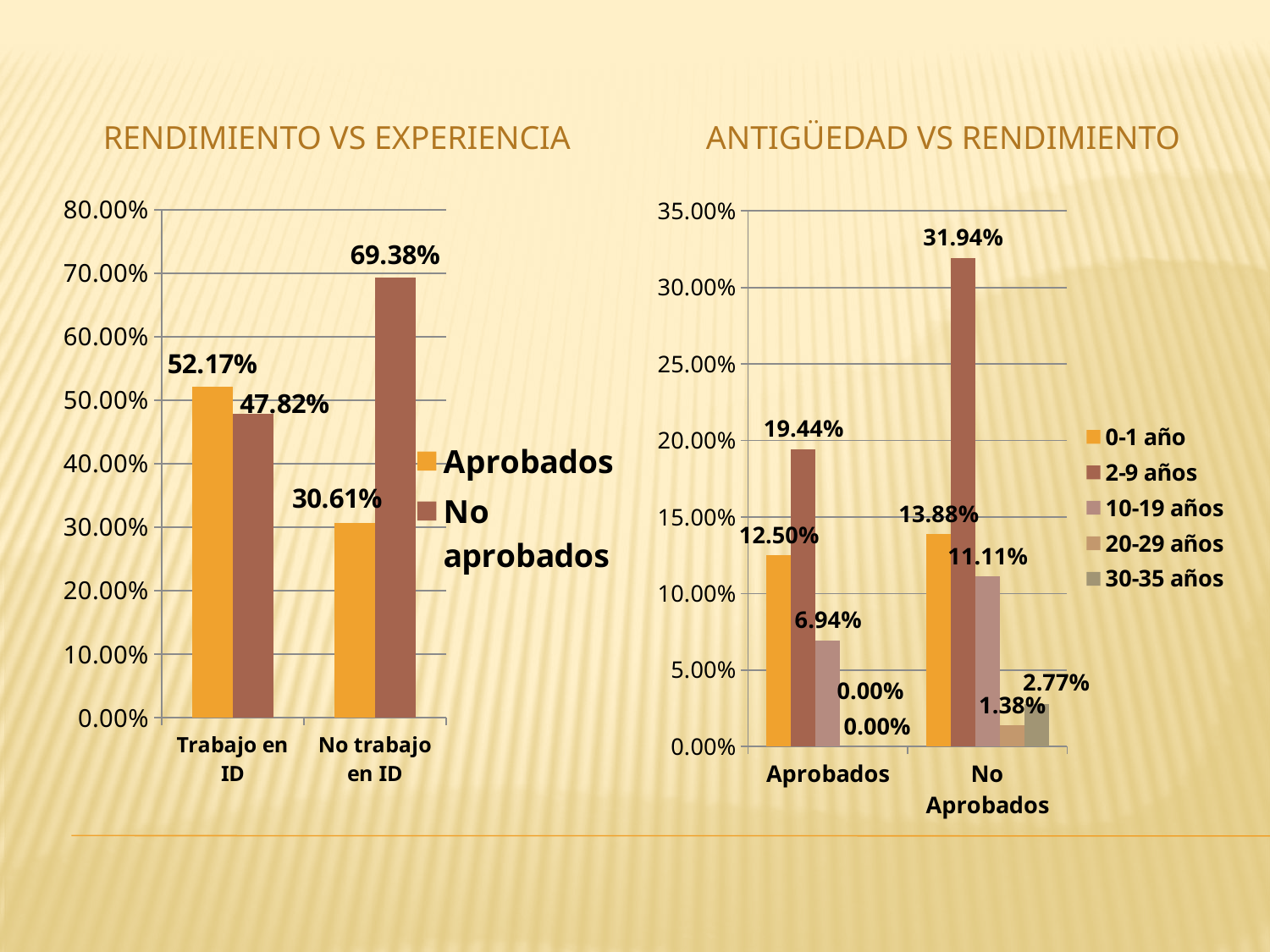
In the ANTIGÜEDAD VS RENDIMIENTO chart, what is the difference between the 0-1 año values for No Aprobados and Aprobados? 1.38% In the ANTIGÜEDAD VS RENDIMIENTO chart, which series has the highest value in the No Aprobados category? 2-9 años In the ANTIGÜEDAD VS RENDIMIENTO chart, what is the value for 2-9 años in the No Aprobados category? 31.94% In the ANTIGÜEDAD VS RENDIMIENTO chart, how many series does the legend list? 5 In the RENDIMIENTO VS EXPERIENCIA chart, which is larger in the Trabajo en ID category, Aprobados or No aprobados? Aprobados What kind of chart is the RENDIMIENTO VS EXPERIENCIA chart? Bar chart In the RENDIMIENTO VS EXPERIENCIA chart, what is the value for No aprobados in the No trabajo en ID category? 69.38% In the RENDIMIENTO VS EXPERIENCIA chart, what is the value for Aprobados in the Trabajo en ID category? 52.17% In the ANTIGÜEDAD VS RENDIMIENTO chart, how many categories are shown on the x axis? 2 In the RENDIMIENTO VS EXPERIENCIA chart, how many series does the legend list? 2 In the ANTIGÜEDAD VS RENDIMIENTO chart, what is the value for 10-19 años in the Aprobados category? 6.94% In the RENDIMIENTO VS EXPERIENCIA chart, what is the difference between Aprobados and No aprobados in the No trabajo en ID category? 38.77%